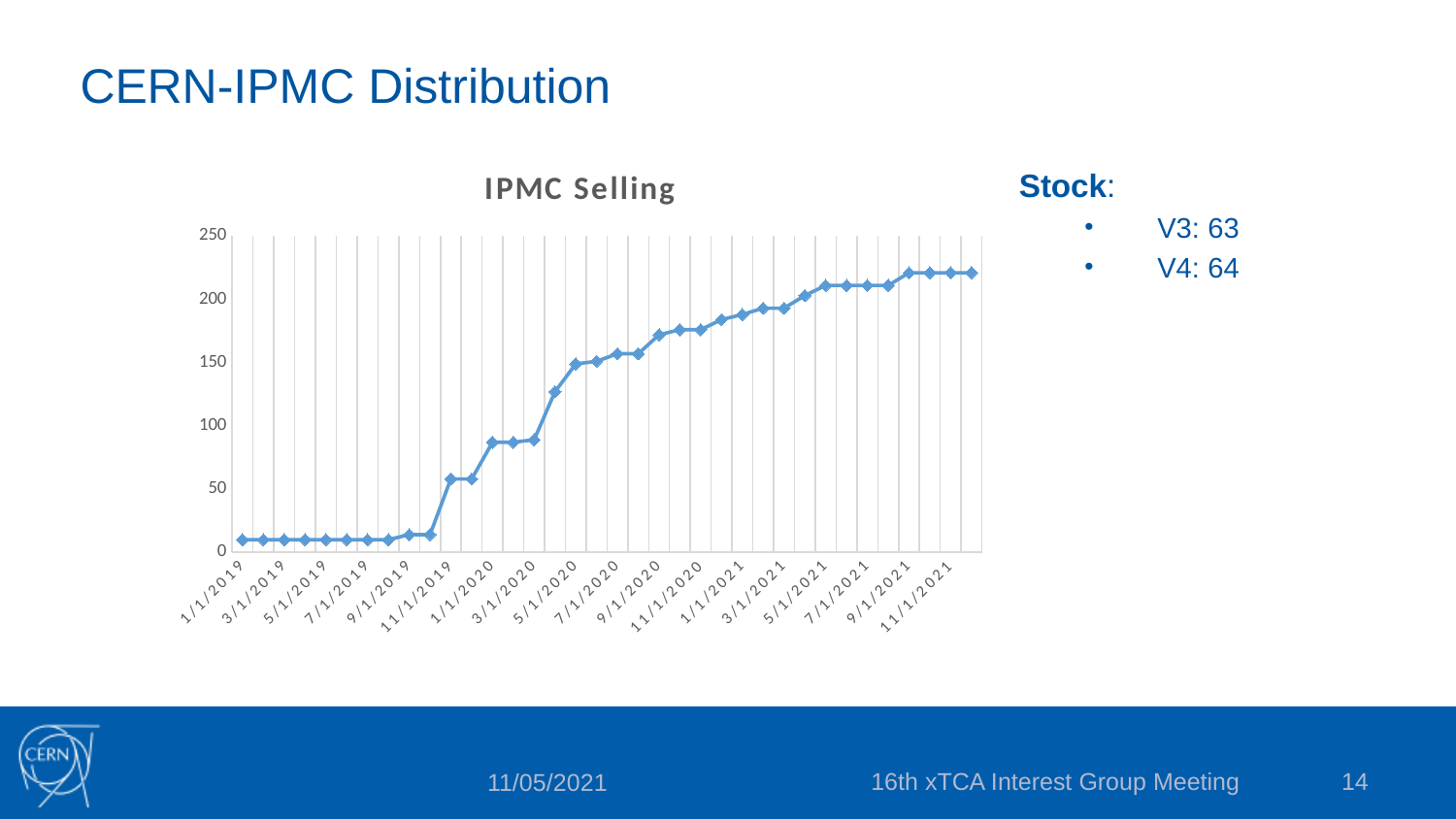
What kind of chart is the IPMC Selling chart? line chart What is the title of the chart on the slide? IPMC Selling Which is larger, the value for 1/1/2019 or the value for 11/1/2021? 11/1/2021 Do the values in the IPMC Selling chart rise or fall from 1/1/2019 to 11/1/2021? rise Is the value for 11/1/2020 greater or less than 150? greater Which is larger, the value for 3/1/2020 or the value for 1/1/2021? 1/1/2021 Is the value for 3/1/2020 greater or less than 100? less How many date labels are shown on the x axis of the IPMC Selling chart? 18 Is the value for 9/1/2019 greater or less than 50? less